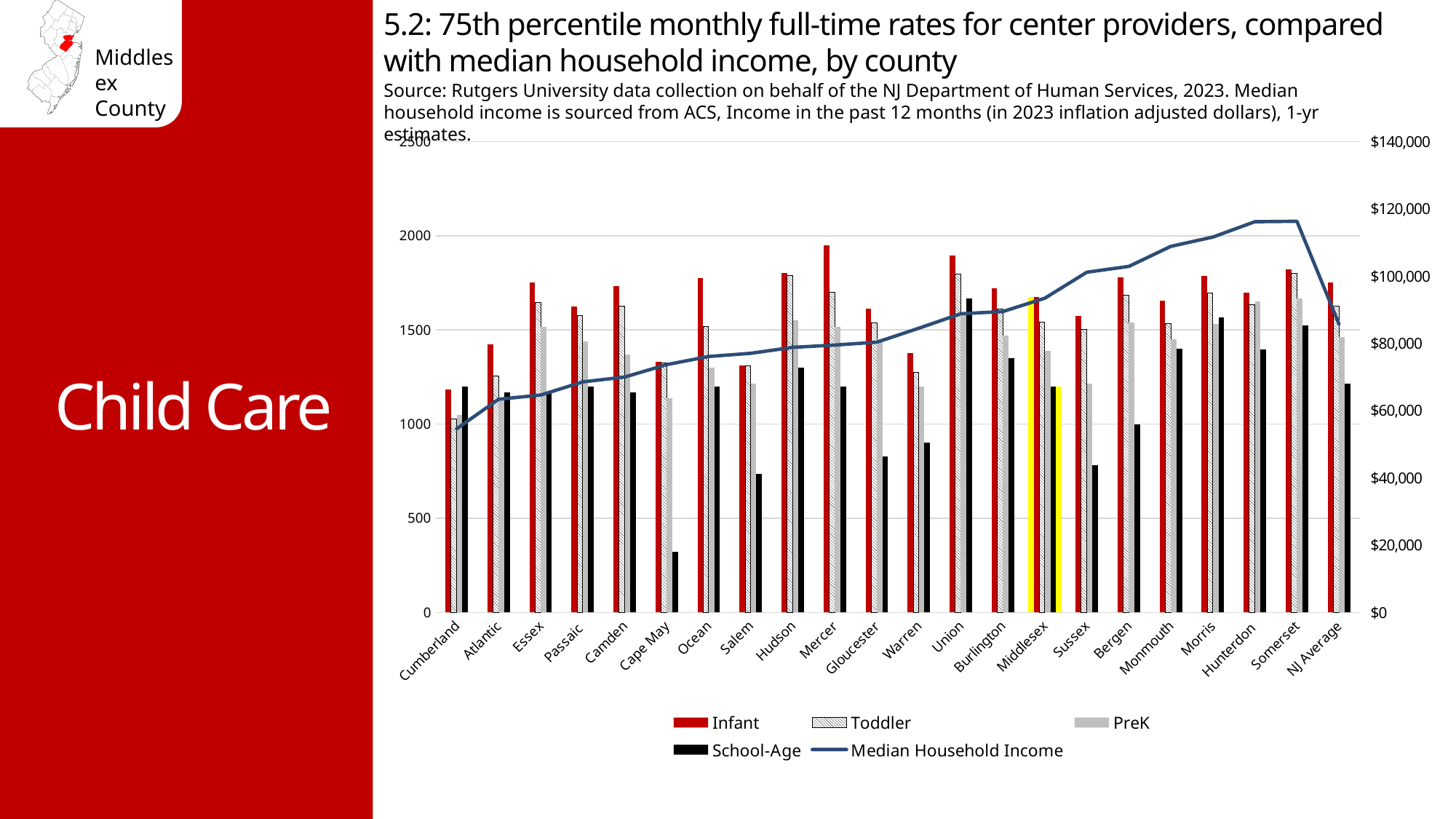
Is the Median Household Income for Somerset greater or less than $100,000? greater How many counties (categories) are shown on the x axis of the chart, including NJ Average? 22 Which county has the highest Infant rate? Mercer Does the Median Household Income line generally rise or fall from Cumberland to Somerset? rise Which county has the lowest Infant rate? Cumberland Which county's bars are highlighted in yellow on the chart? Middlesex Is the Infant rate for Cumberland greater or less than 1000? greater Which county has the lowest School-Age rate? Cape May How many series does the chart's legend list? 5 Is the School-Age rate for Cape May greater or less than 500? less Which is larger, the School-Age rate for Union or the School-Age rate for Warren? Union What kind of chart is shown on the slide? bar chart with a line